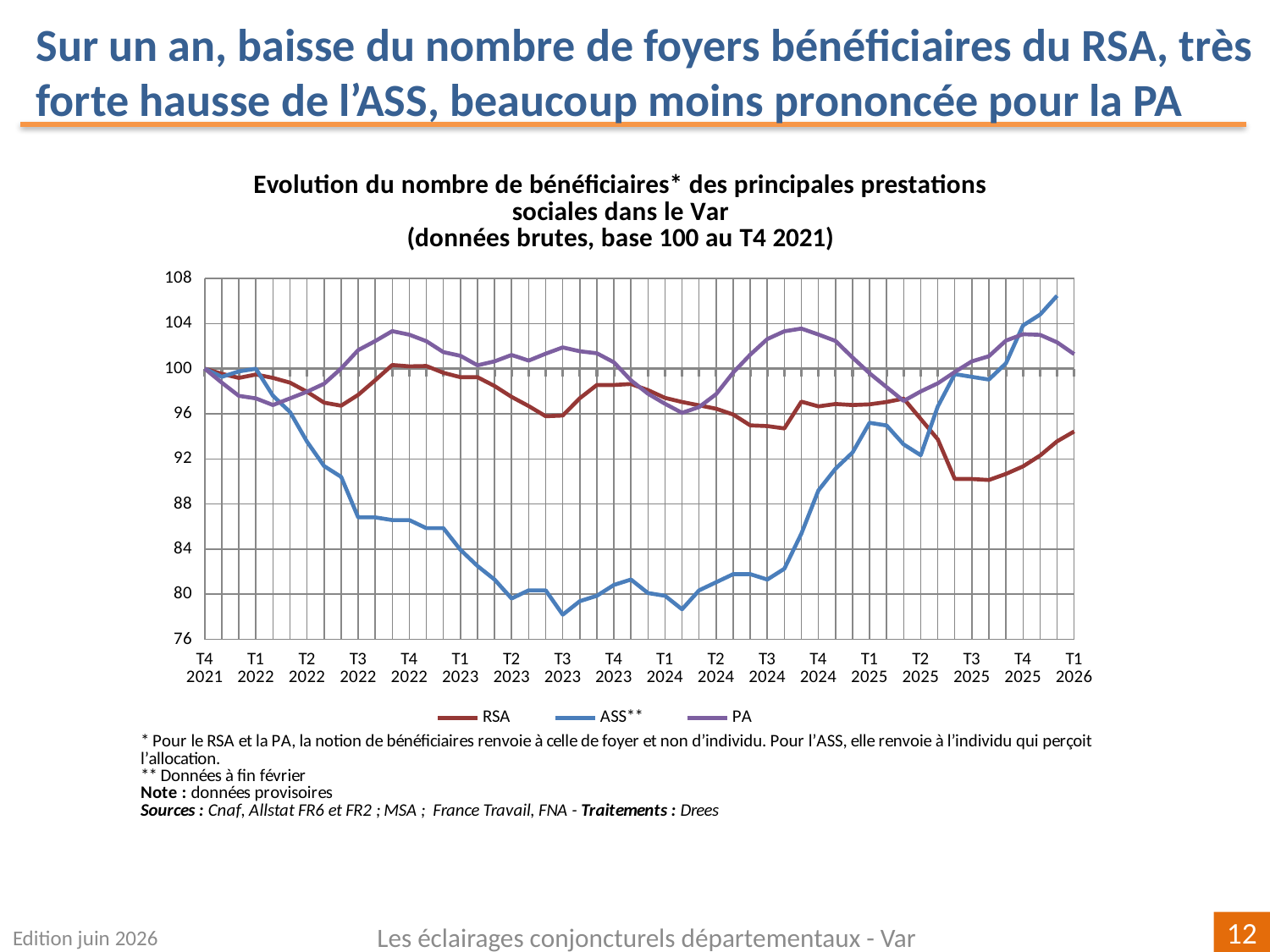
How many quarters are labelled on the x axis? 18 Is the value for PA at T4 2022 greater or less than 100? greater How many series does the legend list? 3 Which series has the lowest value at T3 2023? ASS** Does the ASS** series rise or fall between T4 2021 and T3 2023? fall What kind of chart is shown on the slide? line chart Is the value for ASS** at T3 2023 greater or less than 80? less What is the value of all three series at T4 2021? 100 Is the value for RSA at T3 2025 greater or less than 92? less